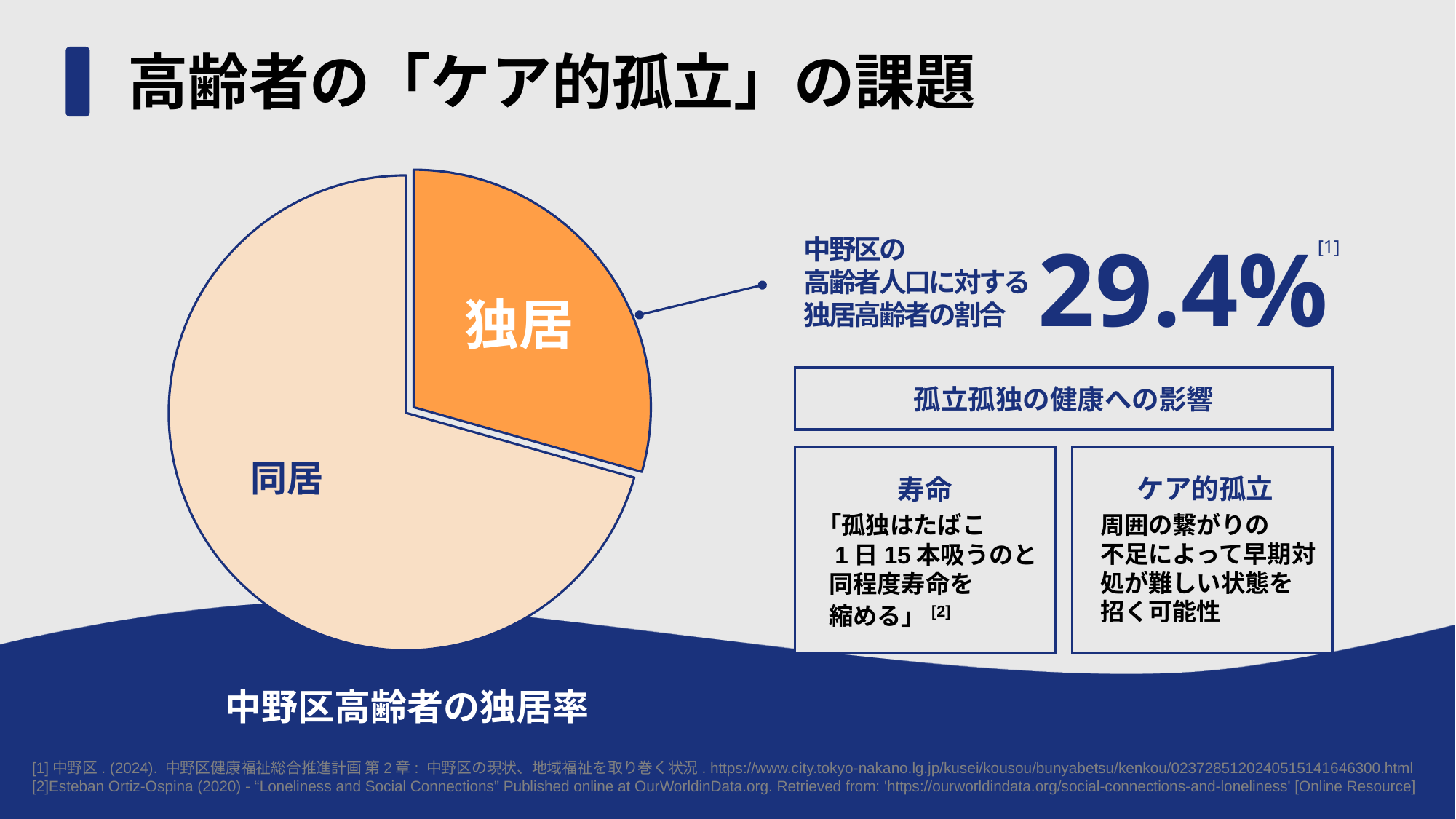
What share of the pie chart does the 独居 slice represent? 29.4% What is the title of the pie chart? 中野区高齢者の独居率 Which slice of the pie chart is the largest? 同居 Which slice of the pie chart is the smallest? 独居 What is the value shown for 独居 in the pie chart? 29.4% What colour is the 独居 slice of the pie chart? orange Which is larger in the pie chart, 同居 or 独居? 同居 What kind of chart is shown on the slide? pie chart How many slices does the pie chart have? 2